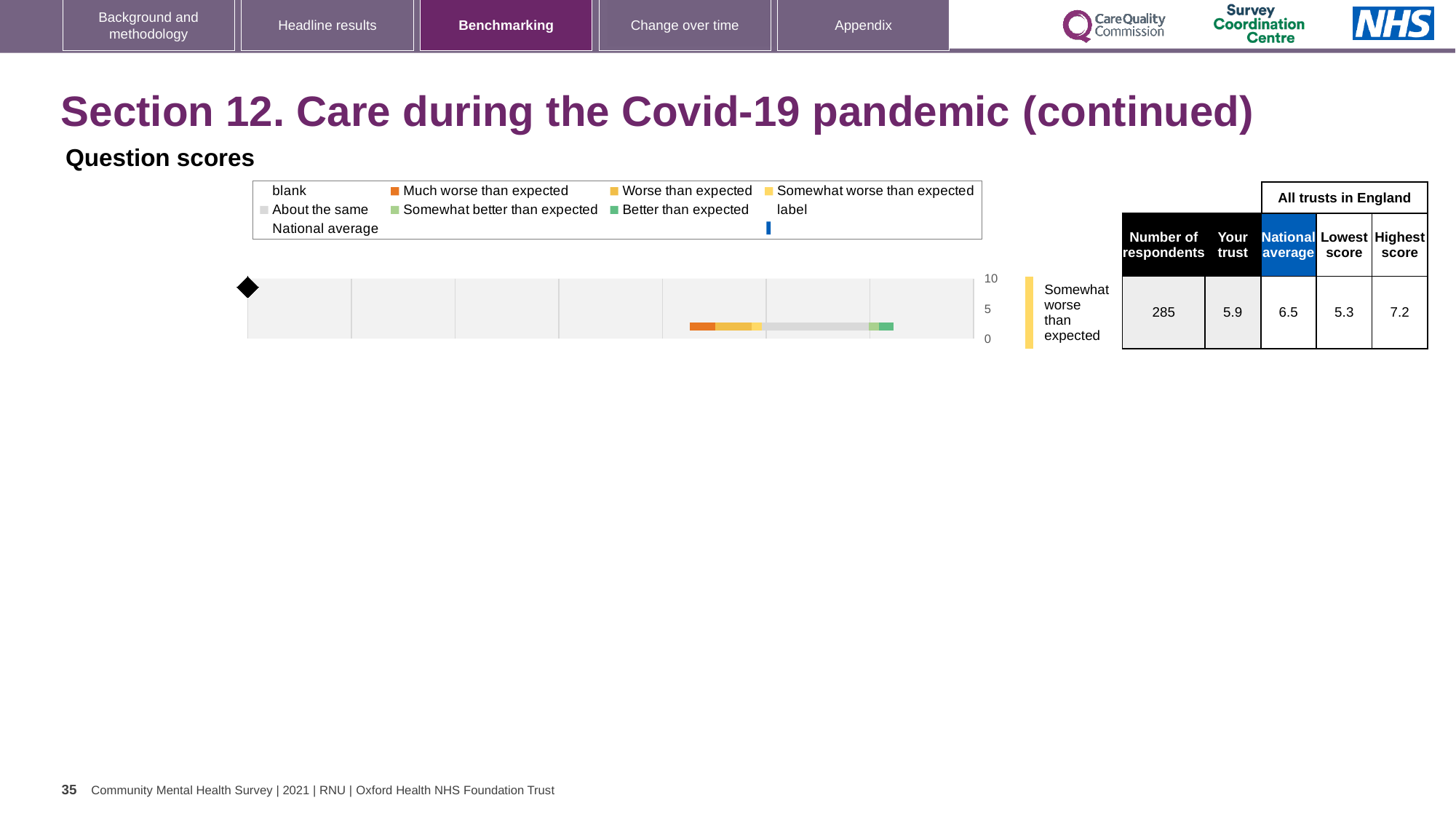
What benchmark category is the trust's score placed in for this question? Somewhat worse than expected What kind of chart is shown on the slide? Bar chart What is the national average score for the question shown on the chart? 6.5 What is the lowest score among all trusts in England for this question? 5.3 What is the highest score among all trusts in England for this question? 7.2 What is the 'Your trust' score for the question shown on the chart? 5.9 What is the difference between the highest and lowest scores among all trusts in England? 1.9 What colour does the legend use for 'Much worse than expected'? Orange What is the maximum value shown on the chart's score axis? 10 Which is larger for this question: the 'Your trust' score or the national average? National average What is the difference between the national average and the 'Your trust' score? 0.6 How many respondents answered the question shown on the chart? 285